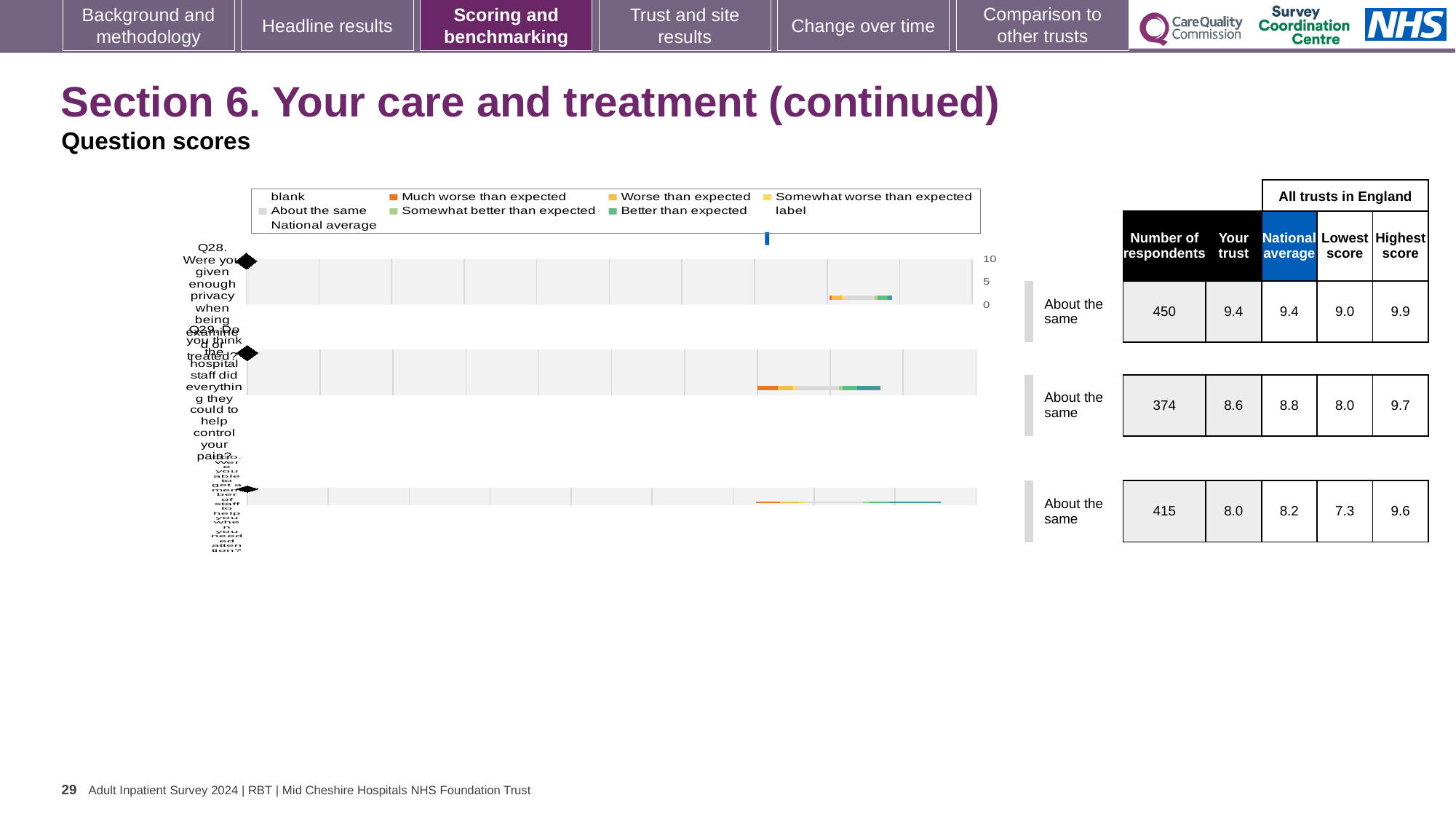
For Q29, which is larger: the "Your trust" score or the national average? national average Which question has the highest "Your trust" score in the table? Q28 Which question has the lowest number of respondents in the table? Q29 For Q30, what is the difference between the highest score and the lowest score among all trusts in England? 2.3 In the table next to the chart, what is the "Your trust" score for Q28? 9.4 In the table next to the chart, what is the lowest score among all trusts in England for Q30? 7.3 In the table next to the chart, what is the national average for Q29? 8.8 How many questions (bars) are plotted in the chart? 3 What kind of chart is shown on the slide? bar chart In the table next to the chart, what is the number of respondents for Q28? 450 What colour does the legend use for "Much worse than expected"? orange What is the highest tick value shown on the chart's score axis? 10